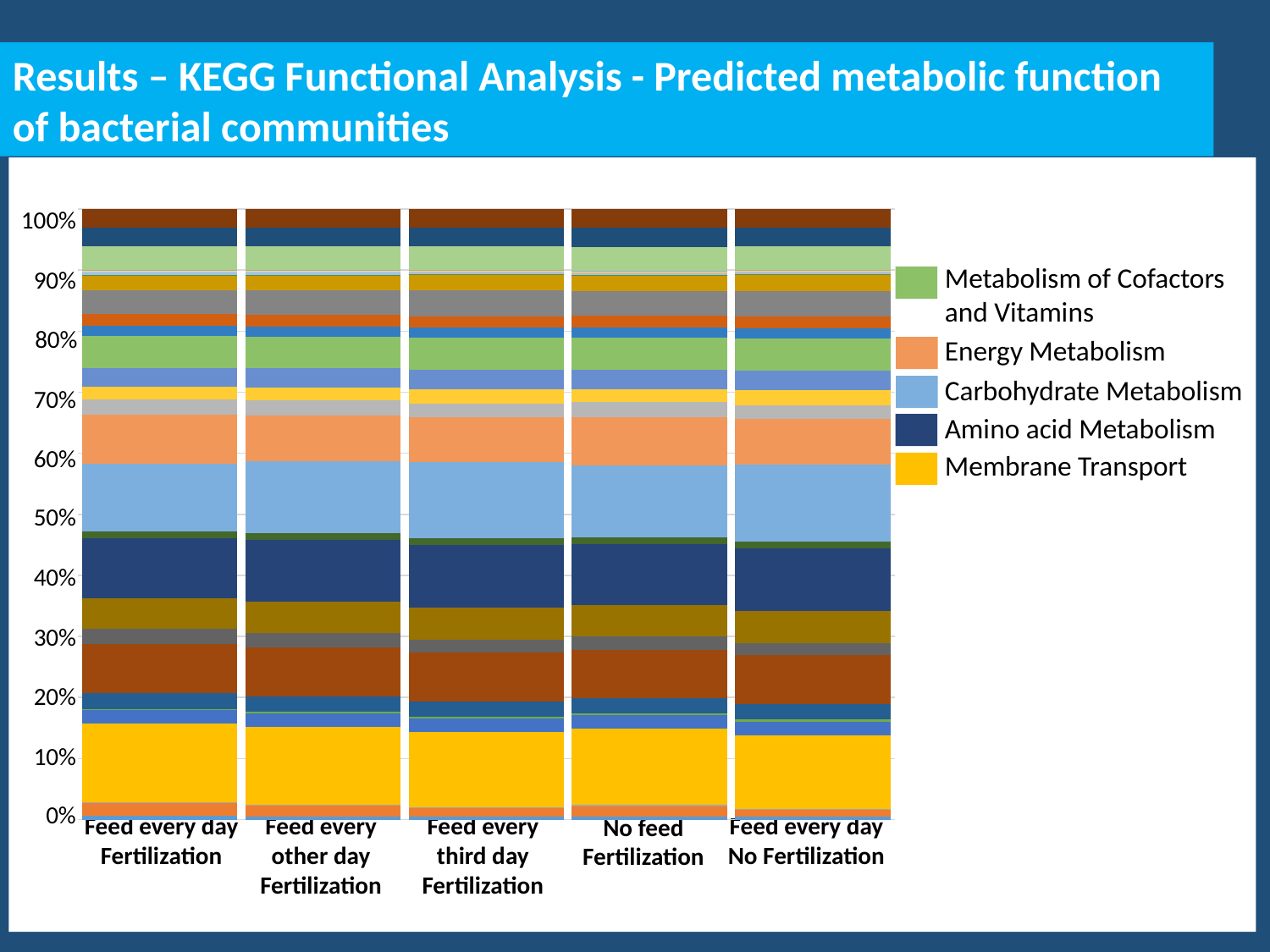
What is the total height of each stacked bar on the percentage axis? 100% Is the Membrane Transport share for 'Feed every day Fertilization' greater or less than 10%? greater How many treatment categories are shown along the x axis? 5 In the 'Feed every other day Fertilization' bar, which is larger: the Carbohydrate Metabolism share or the Metabolism of Cofactors and Vitamins share? Carbohydrate Metabolism In the 'Feed every day Fertilization' bar, which is larger: the Membrane Transport share or the Energy Metabolism share? Membrane Transport Which legend entry is shown in dark blue? Amino acid Metabolism What kind of chart is shown on the slide? Stacked bar chart How many series does the legend list? 5 Is the Carbohydrate Metabolism share for 'Feed every third day Fertilization' greater or less than 10%? greater Is the Membrane Transport share for 'Feed every day No Fertilization' greater or less than 20%? less Which legend entry is shown in yellow? Membrane Transport